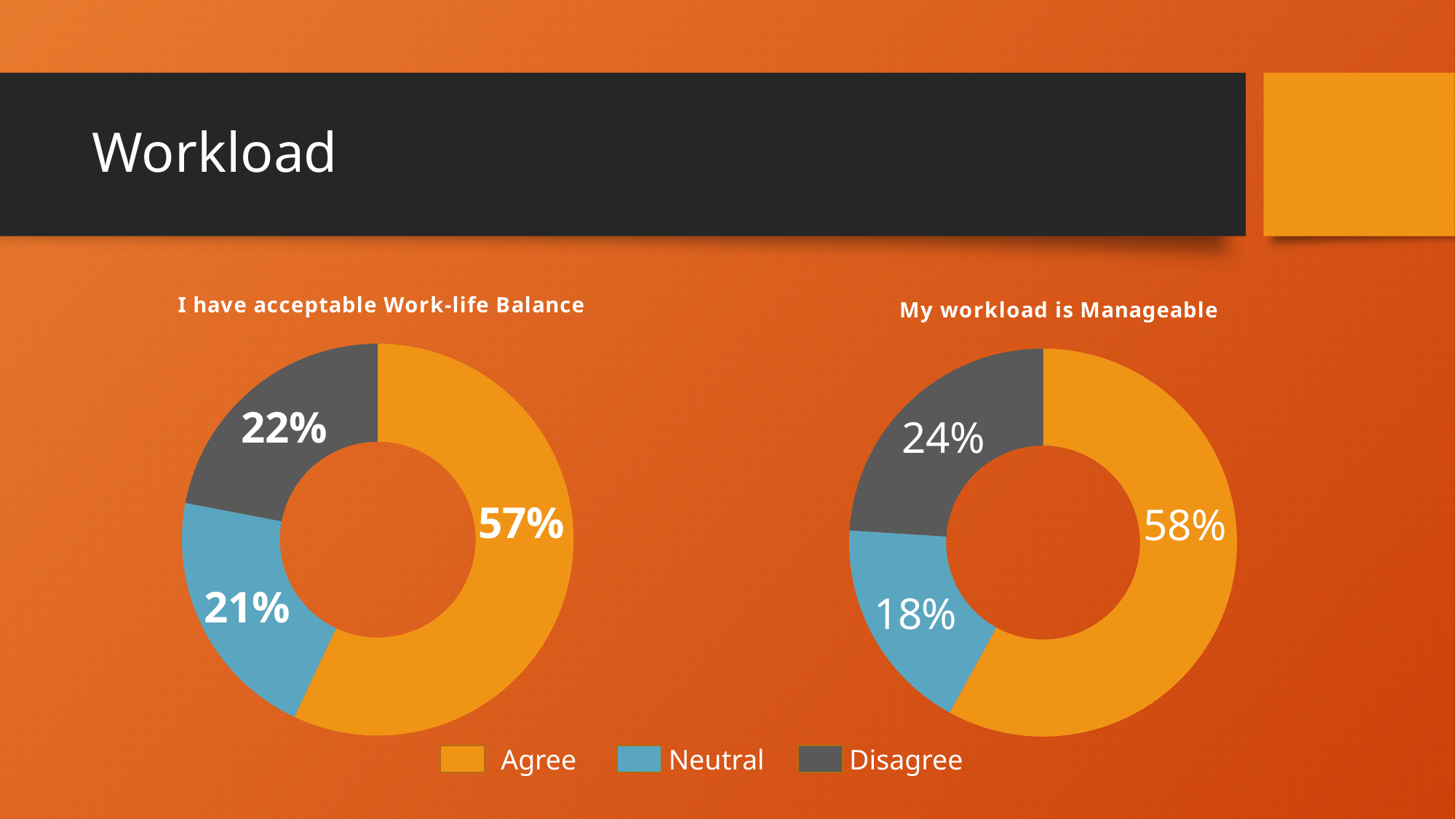
In the 'I have acceptable Work-life Balance' chart, which response has the largest share? Agree In the 'My workload is Manageable' chart, what is the difference between the Agree and Disagree shares? 34% In the 'I have acceptable Work-life Balance' chart, what percentage of respondents are Neutral? 21% In the 'I have acceptable Work-life Balance' chart, what percentage of respondents Agree? 57% In the 'My workload is Manageable' chart, what percentage of respondents Disagree? 24% What type of chart is used for 'I have acceptable Work-life Balance'? Doughnut chart In the 'My workload is Manageable' chart, what percentage of respondents are Neutral? 18% Which chart has the larger Agree share, 'I have acceptable Work-life Balance' or 'My workload is Manageable'? My workload is Manageable How many categories does the 'My workload is Manageable' chart show? 3 In the 'My workload is Manageable' chart, which response has the smallest share? Neutral Which colour represents Neutral in the legend? Blue In the 'I have acceptable Work-life Balance' chart, what is the difference between the Disagree and Neutral shares? 1%